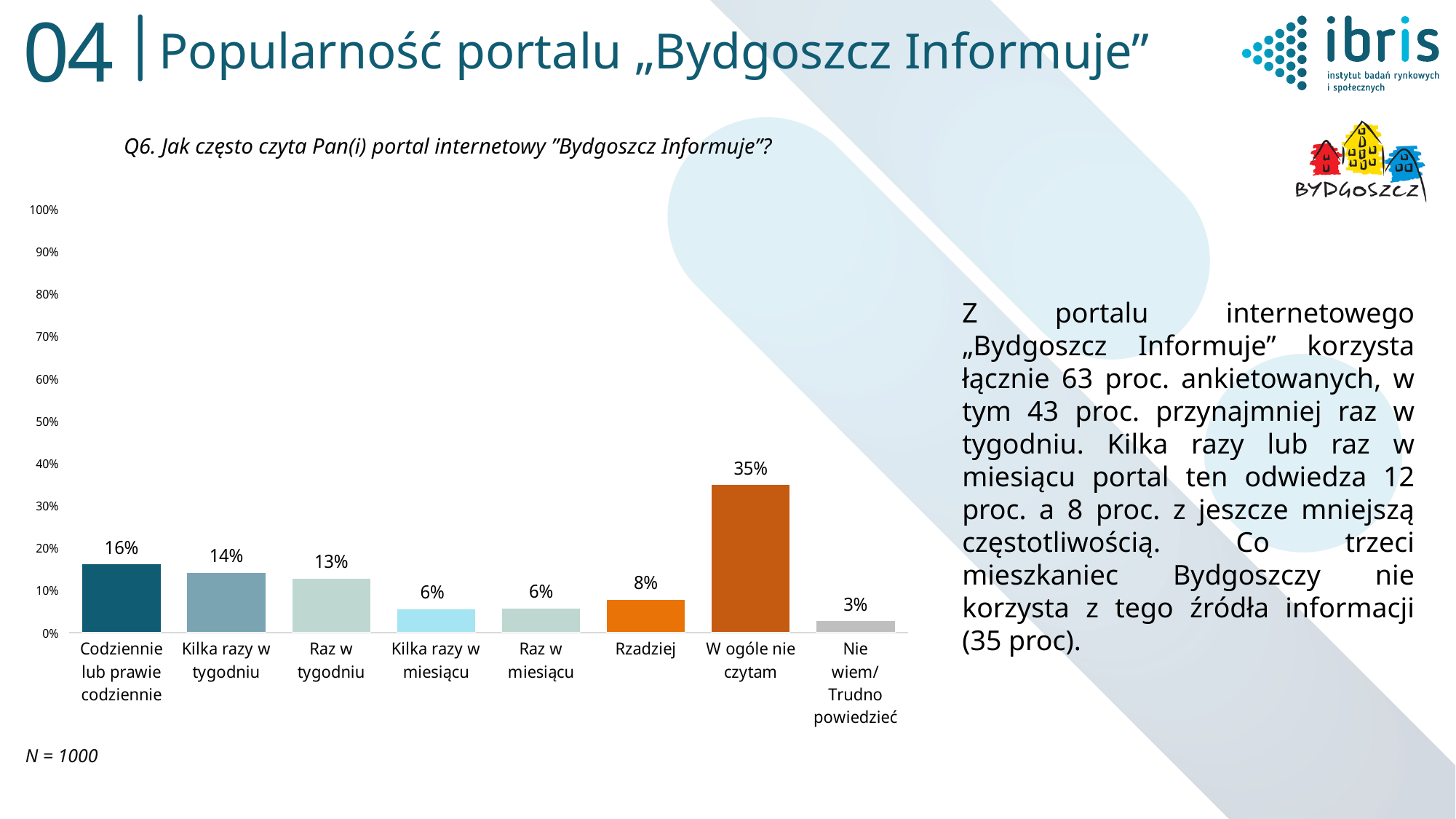
Which category has the highest value? W ogóle nie czytam Which category has the lowest value? Nie wiem/ Trudno powiedzieć What is the value for "Nie wiem/ Trudno powiedzieć"? 3% What kind of chart is shown on the slide? bar chart What is the sample size (N) stated on the slide? N = 1000 What is the difference between "W ogóle nie czytam" and "Codziennie lub prawie codziennie"? 19% What is the value for "Codziennie lub prawie codziennie"? 16% What is the value for "W ogóle nie czytam"? 35% Which is larger, "Kilka razy w tygodniu" or "Raz w tygodniu"? Kilka razy w tygodniu What is the value for "Rzadziej"? 8% How many categories are shown on the x axis? 8 Is the value for "W ogóle nie czytam" greater or less than 30%? greater